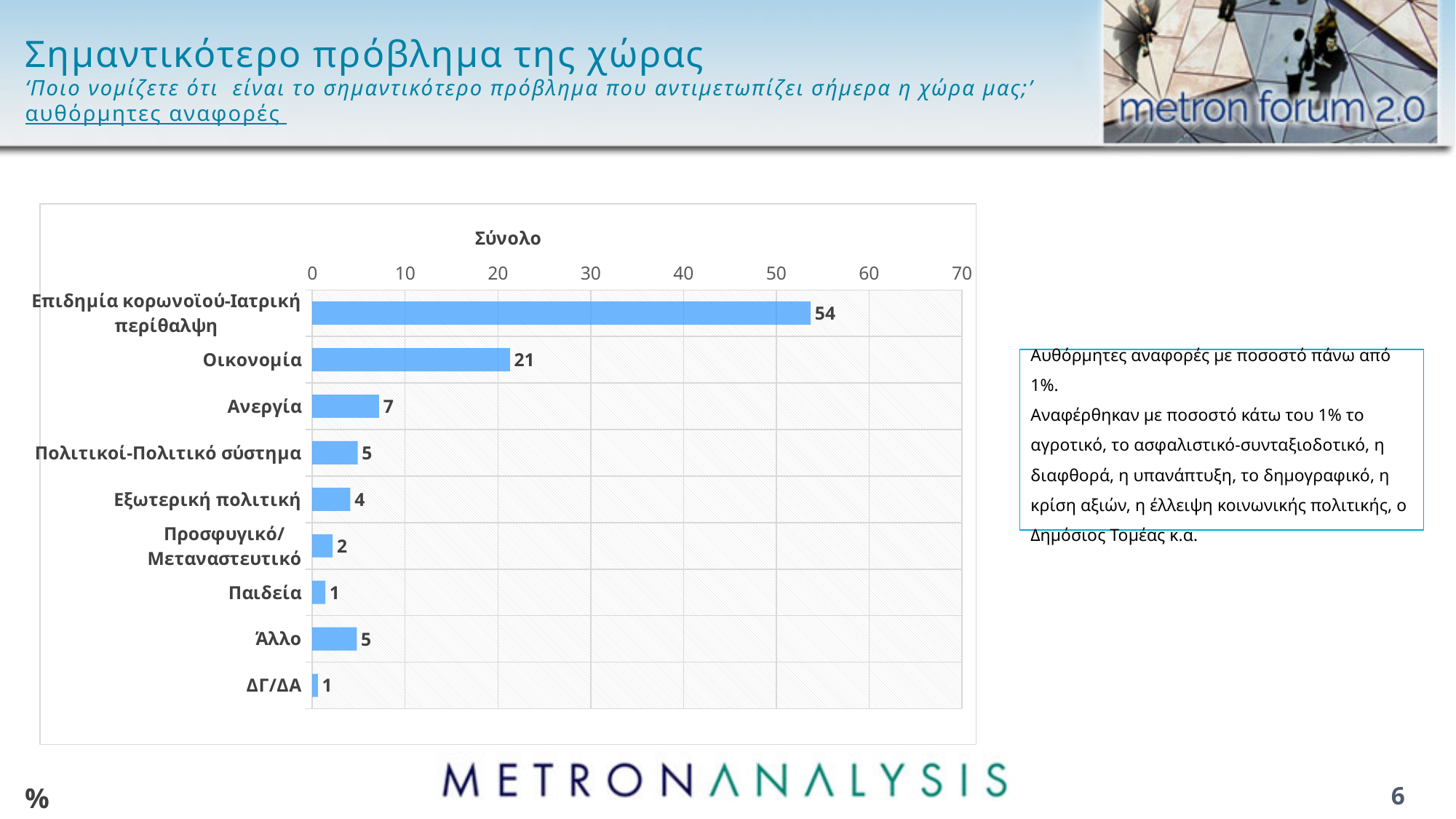
What is the value for Προσφυγικό/Μεταναστευτικό? 2 What is the value for Ανεργία? 7 Is the value for Επιδημία κορωνοϊού-Ιατρική περίθαλψη greater or less than 50? greater What is the title of the chart? Σύνολο What is the value for Οικονομία? 21 How many categories are shown in the chart? 9 What kind of chart is shown on the slide? bar chart What is the value for Εξωτερική πολιτική? 4 What is the difference between the values for Ανεργία and Παιδεία? 6 What is the difference between the values for Επιδημία κορωνοϊού-Ιατρική περίθαλψη and Οικονομία? 33 Which is larger, the value for Ανεργία or the value for Πολιτικοί-Πολιτικό σύστημα? Ανεργία Which category has the highest value? Επιδημία κορωνοϊού-Ιατρική περίθαλψη